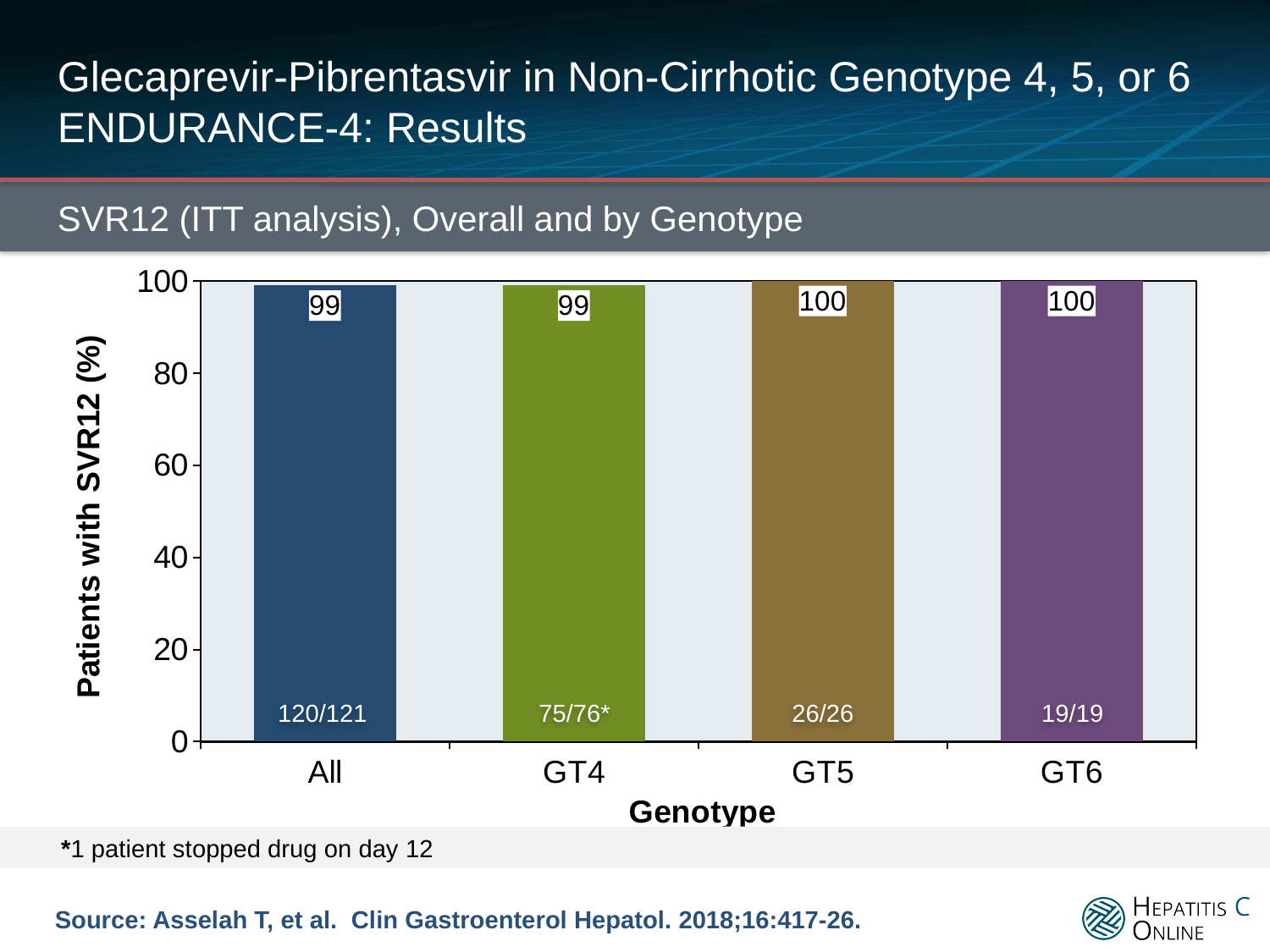
What fraction of patients is shown inside the GT6 bar? 19/19 What is the difference in SVR12 percentage between GT5 and GT4? 1 What fraction of patients is shown inside the All bar? 120/121 What is the label of the y axis? Patients with SVR12 (%) What is the title of the chart? SVR12 (ITT analysis), Overall and by Genotype Which genotype groups have an SVR12 of 100%? GT5 and GT6 Is the SVR12 value for GT6 greater or less than 80? greater What kind of chart is shown on the slide? Bar chart What is the SVR12 percentage for GT4? 99 What is the SVR12 percentage for GT5? 100 How many categories are shown on the x axis? 4 What is the SVR12 percentage for the All group? 99